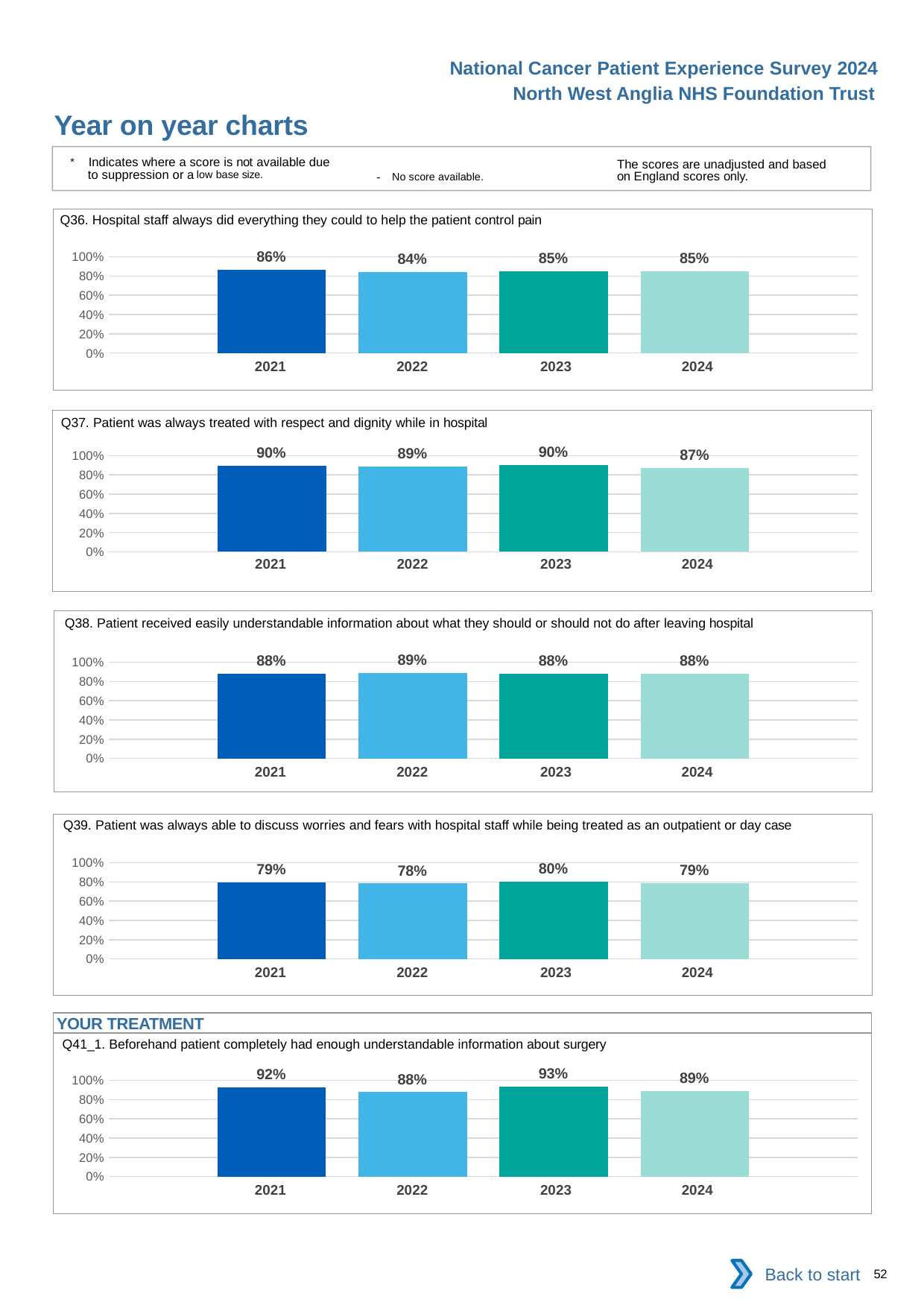
In the Q38 chart, which year has the highest value? 2022 In the Q38 chart, how many years are shown? 4 In the Q41_1 chart, what is the value for 2022? 88% What kind of chart is the Q36 chart? Bar chart In the Q37 chart, is the value for 2022 greater or less than 80%? greater In the Q39 chart, which is larger, the value for 2021 or the value for 2022? 2021 In the Q36 chart, which year has the lowest value? 2022 In the Q36 chart, what is the value for 2021? 86% In the Q37 chart, what is the value for 2024? 87% In the Q41_1 chart, what is the difference between the 2023 value and the 2022 value? 5% In the Q39 chart, what is the value for 2023? 80% In the Q37 chart, what is the difference between the 2023 value and the 2024 value? 3%